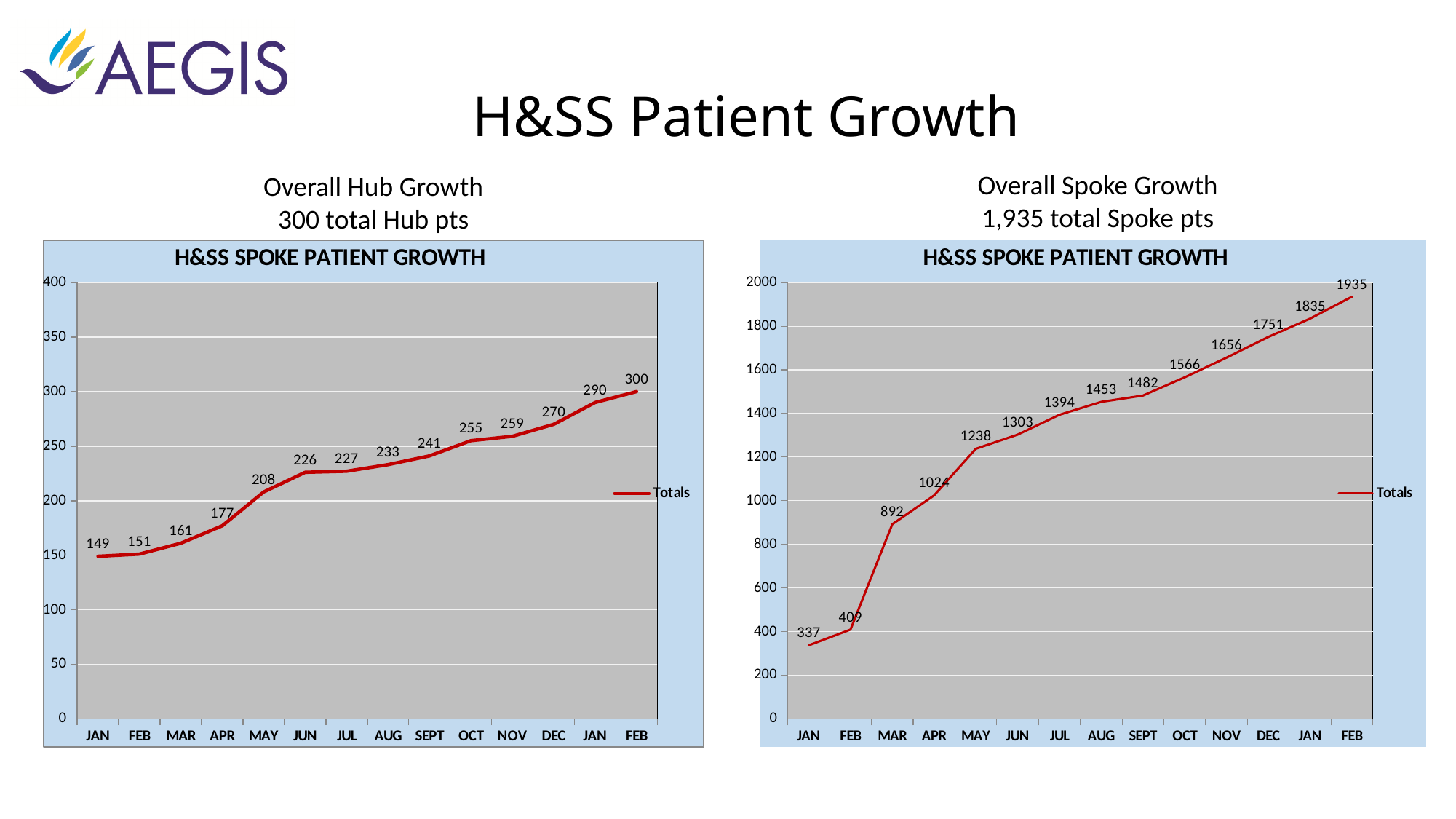
In the left chart (Overall Hub Growth), what is the value for MAY? 208 In the right chart (Overall Spoke Growth), do the values rise or fall from JAN to the final FEB? Rise How many data points are plotted in the left chart (Overall Hub Growth)? 14 In the right chart (Overall Spoke Growth), what is the difference between the values for MAR and FEB (the first FEB)? 483 What kind of chart is the right chart (Overall Spoke Growth)? Line chart In the right chart (Overall Spoke Growth), what is the value for MAR? 892 In the right chart (Overall Spoke Growth), which point has the highest value? FEB (the final FEB), 1935 In the right chart (Overall Spoke Growth), what is the value for OCT? 1566 In the right chart (Overall Spoke Growth), which is larger, the value for JUL or the value for MAY? JUL In the left chart (Overall Hub Growth), what is the value for DEC? 270 In the left chart (Overall Hub Growth), what is the difference between the values for OCT and APR? 78 In the left chart (Overall Hub Growth), which month has the lowest value? JAN (the first JAN)